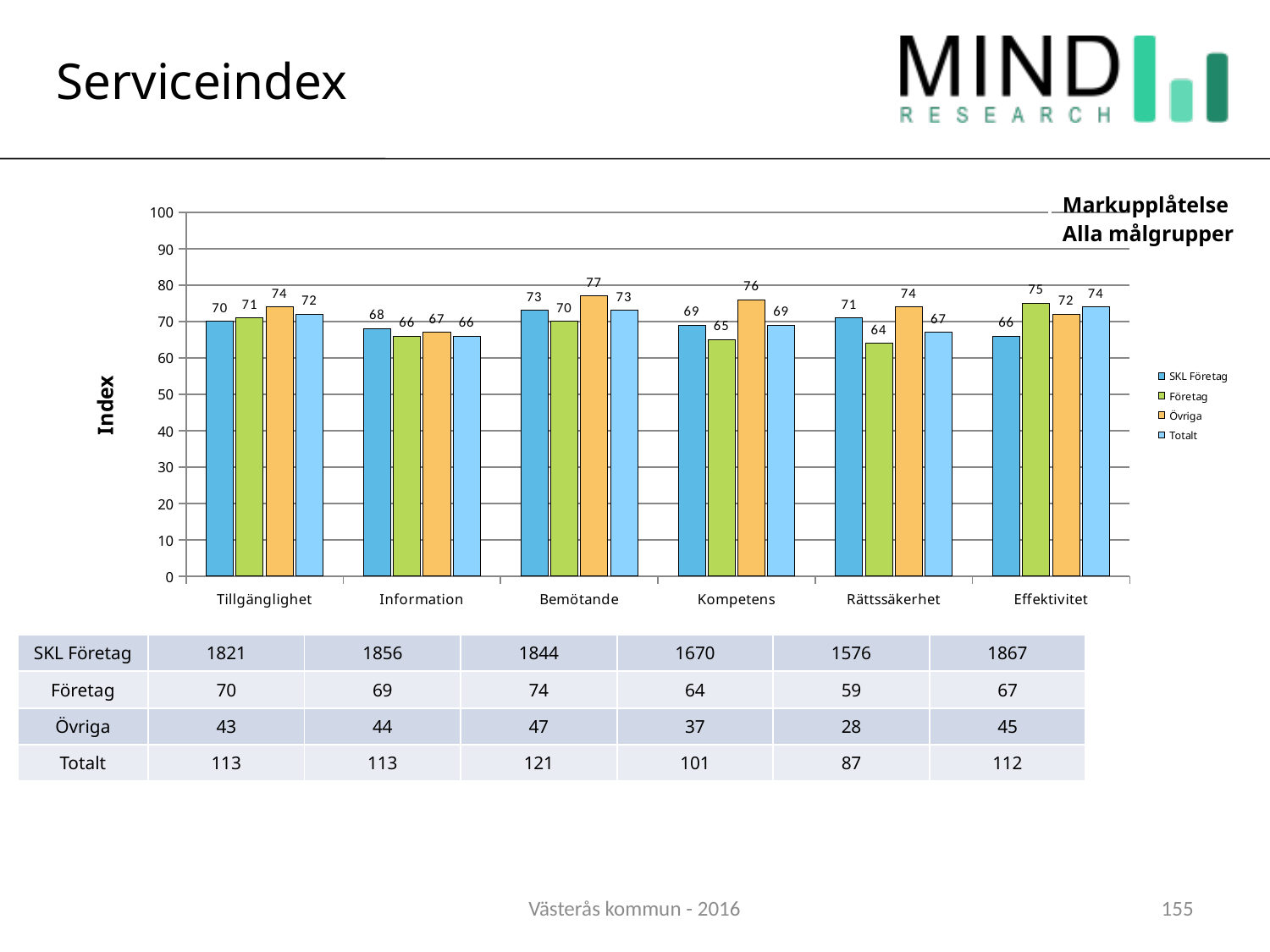
Which category has the lowest value for the Företag series? Rättssäkerhet What is the label on the vertical axis of the chart? Index What is the value for Totalt in the Effektivitet category? 74 What kind of chart is shown on the slide? Bar chart What is the difference between the Övriga and Företag values in the Kompetens category? 11 What is the value for Företag in the Rättssäkerhet category? 64 How many categories are shown on the x axis of the chart? 6 Which is larger in the Effektivitet category: the value for SKL Företag or the value for Företag? Företag How many series does the chart legend list? 4 What is the value for Övriga in the Bemötande category? 77 What is the value for SKL Företag in the Information category? 68 Which category has the highest value for the Övriga series? Bemötande